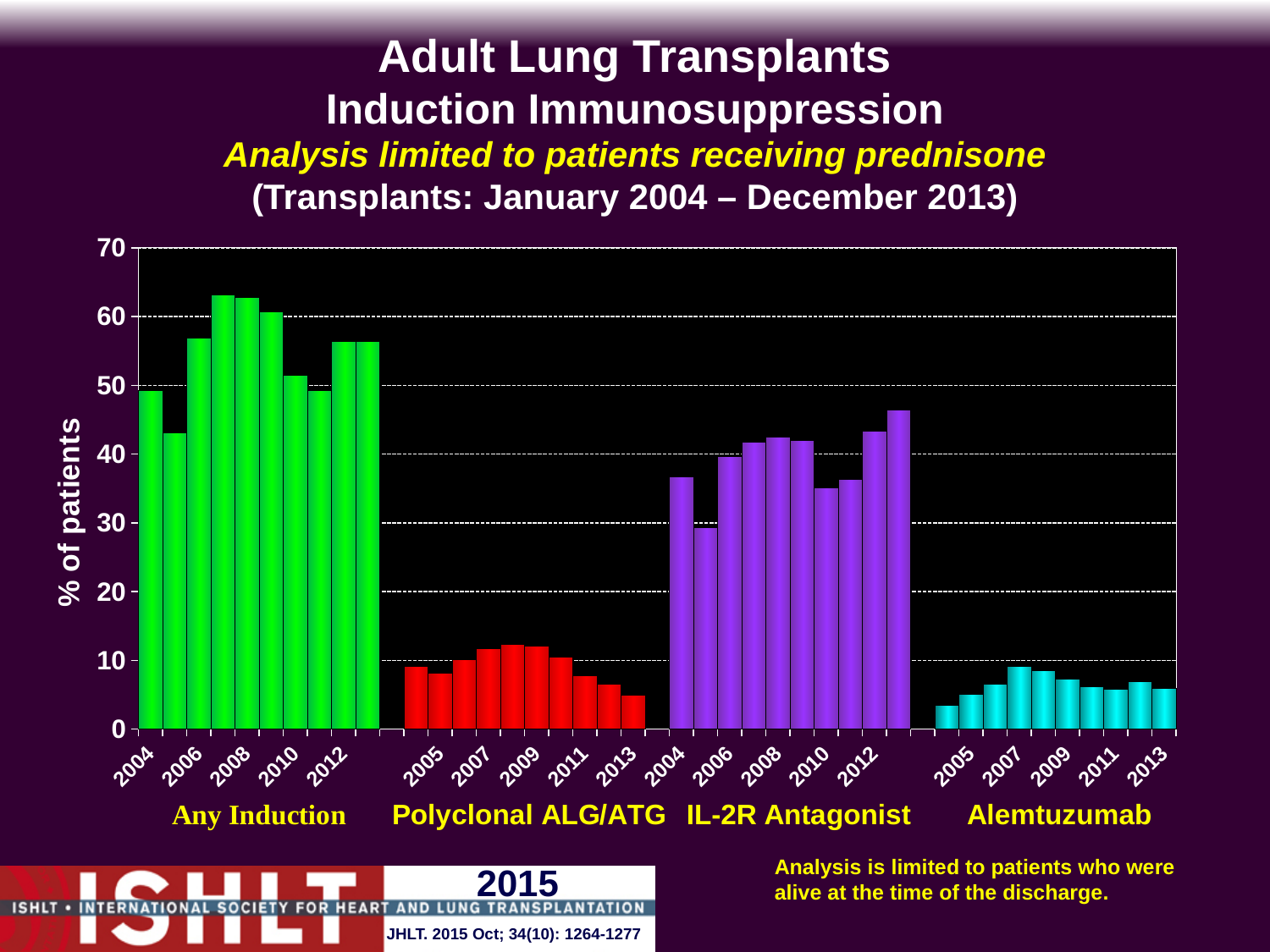
How many induction immunosuppression groups are shown on the chart? 4 In which year is the IL-2R Antagonist value highest? 2013 What is the label on the y axis of the chart? % of patients How many yearly bars are plotted in the Any Induction group? 10 Is the value for IL-2R Antagonist in 2013 greater or less than 40? greater Is the value for Polyclonal ALG/ATG in 2013 greater or less than 10? less In which year is the Polyclonal ALG/ATG value lowest? 2013 Is the value for Any Induction in 2005 greater or less than 50? less What kind of chart is shown on the slide? bar chart Which is larger for Any Induction: the value in 2006 or the value in 2010? 2006